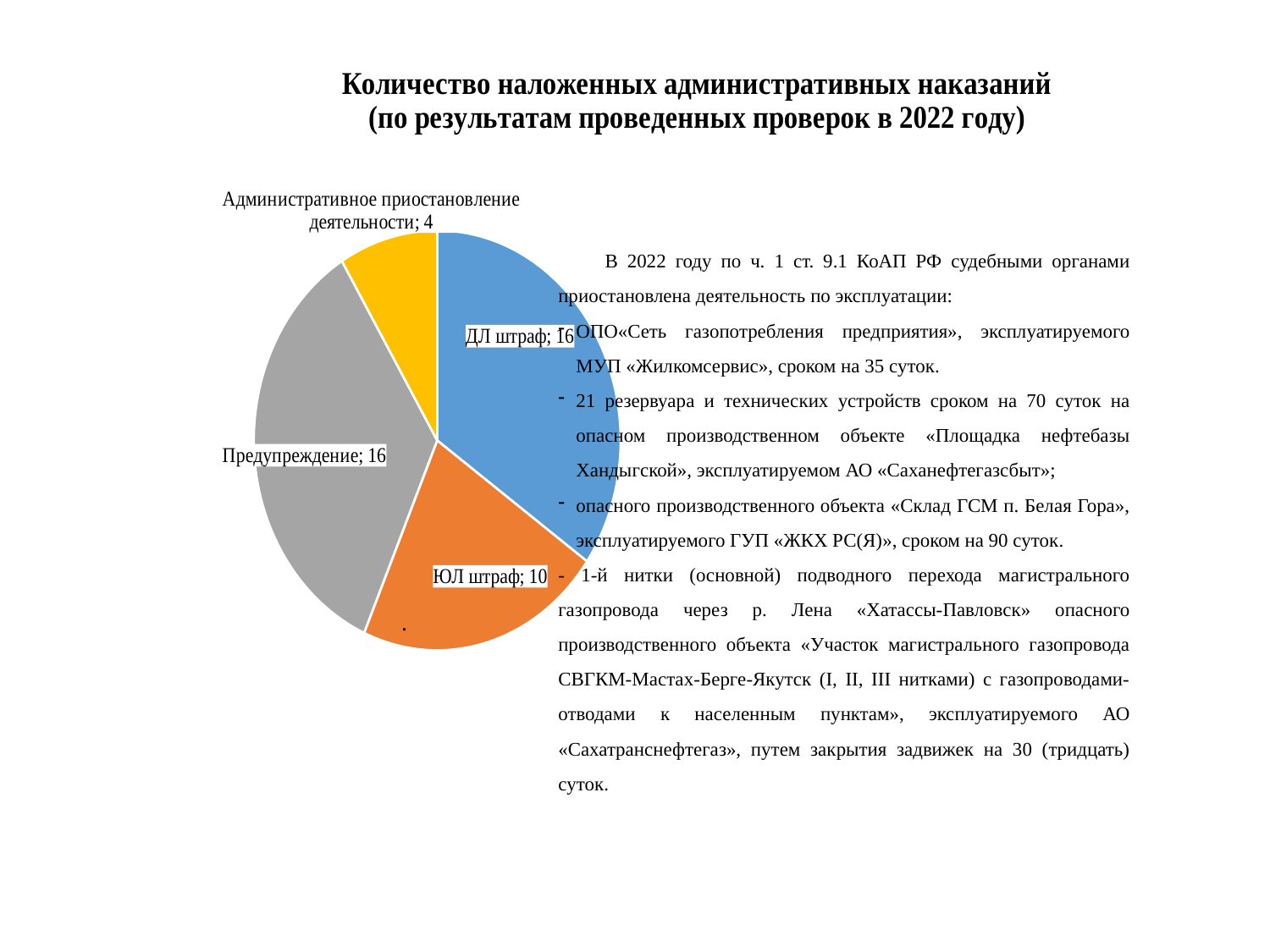
What is the value for Предупреждение in the pie chart? 16 What colour is the ЮЛ штраф slice in the pie chart? orange How many slices does the pie chart have? 4 What is the value for ДЛ штраф in the pie chart? 16 Which category has the smallest slice in the pie chart? Административное приостановление деятельности What is the total of all the values shown in the pie chart? 46 What is the difference between the values for ДЛ штраф and ЮЛ штраф? 6 What is the value for ЮЛ штраф in the pie chart? 10 Which is larger, the value for ЮЛ штраф or the value for Предупреждение? Предупреждение What is the title of the chart on the slide? Количество наложенных административных наказаний (по результатам проведенных проверок в 2022 году) What kind of chart is shown on the slide? pie chart What is the value for Административное приостановление деятельности in the pie chart? 4